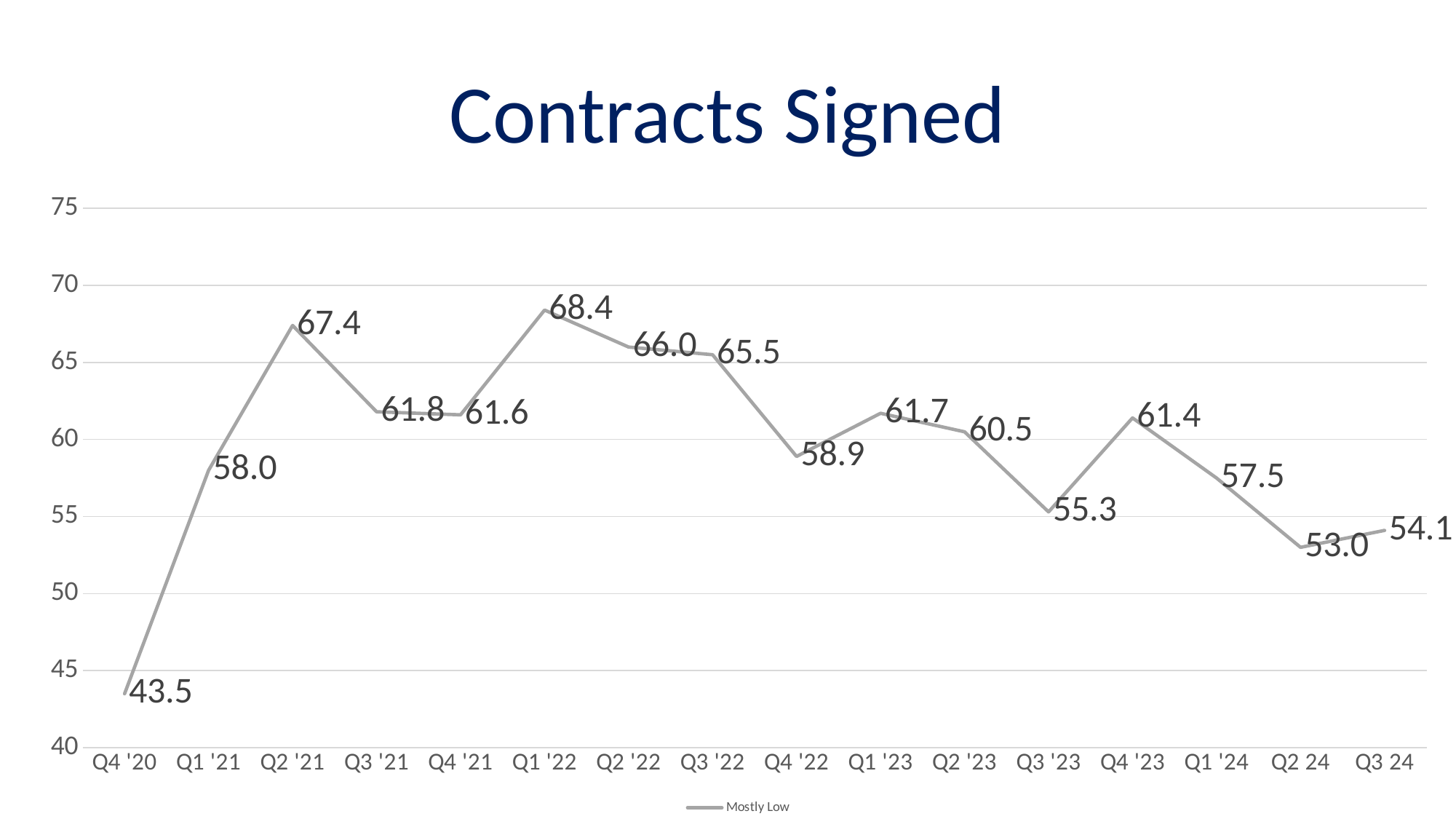
Which quarter has the highest value? Q1 '22 What is the difference between the values for Q1 '22 and Q2 24? 15.4 How many quarters are plotted on the x axis? 16 Which quarter has the lowest value? Q4 '20 What is the difference between the values for Q1 '21 and Q4 '20? 14.5 What is the value for Q2 '21? 67.4 What is the title of the chart? Contracts Signed What is the value for Q3 24? 54.1 What kind of chart is shown? Line chart Which is larger, the value for Q4 '23 or the value for Q3 '23? Q4 '23 What is the value for Q4 '22? 58.9 How many series does the legend list? 1